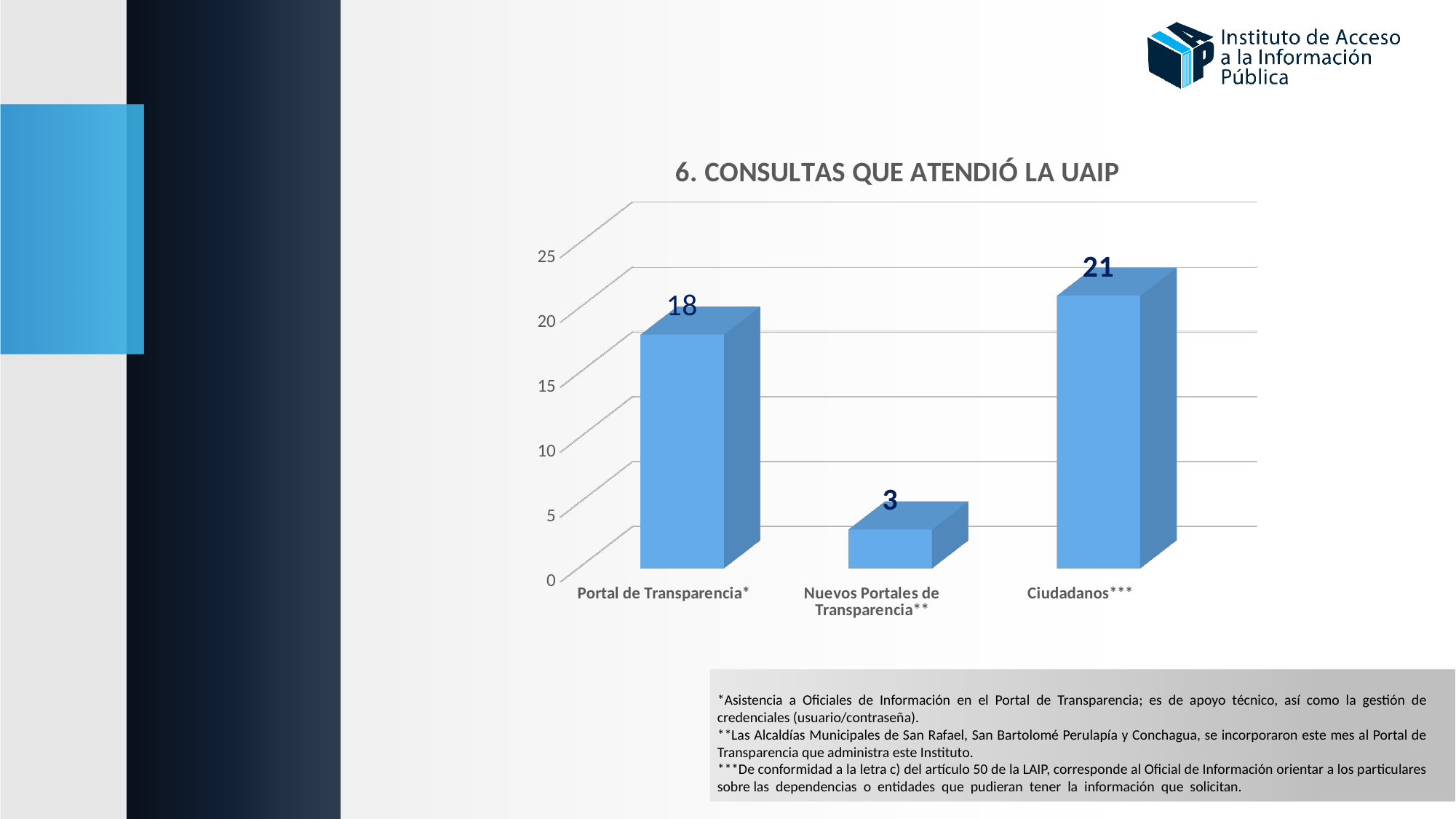
Is the value for Nuevos Portales de Transparencia** greater or less than 5? less What is the difference between the values for Ciudadanos*** and Portal de Transparencia*? 3 What is the difference between the values for Portal de Transparencia* and Nuevos Portales de Transparencia**? 15 What is the value for Ciudadanos***? 21 What is the value for Portal de Transparencia*? 18 What kind of chart is shown on the slide? bar chart Which category has the lowest value? Nuevos Portales de Transparencia** How many categories are shown in the chart? 3 What is the title of the chart? 6. CONSULTAS QUE ATENDIÓ LA UAIP Which category has the highest value? Ciudadanos*** Which is larger, the value for Portal de Transparencia* or the value for Ciudadanos***? Ciudadanos*** What is the value for Nuevos Portales de Transparencia**? 3